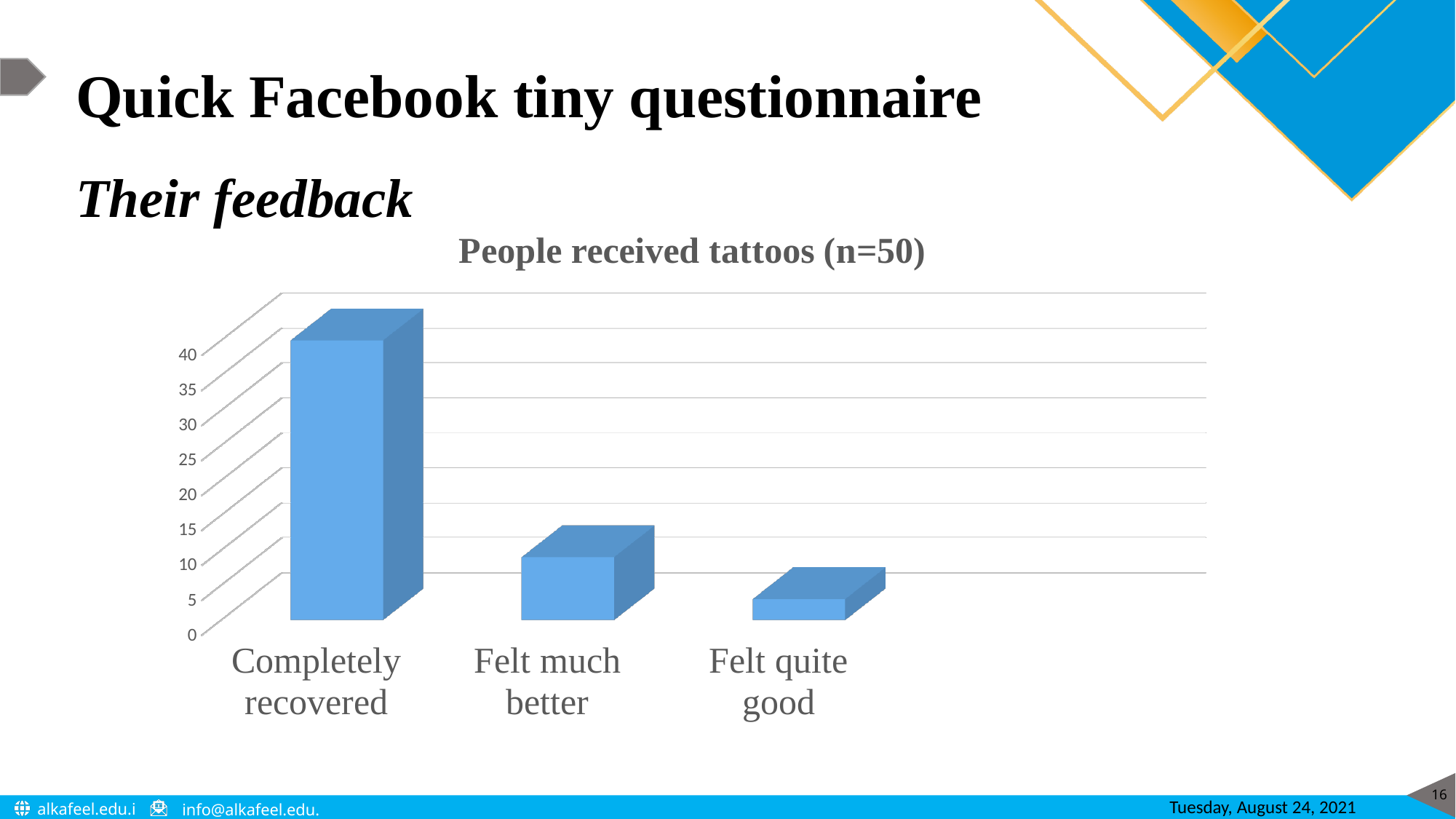
What kind of chart is shown on the slide? bar chart Which category has the highest value? Completely recovered Is the value for Felt much better greater or less than 15? less What is the highest tick value labelled on the vertical axis? 40 Which is larger, the value for Felt much better or the value for Felt quite good? Felt much better Which category has the lowest value? Felt quite good Is the value for Felt quite good greater or less than 10? less What is the title of the chart? People received tattoos (n=50) How many categories are shown on the x axis of the chart? 3 Which is larger, the value for Completely recovered or the value for Felt much better? Completely recovered Is the value for Completely recovered greater or less than 30? greater Do the values rise or fall from left to right across the categories? fall